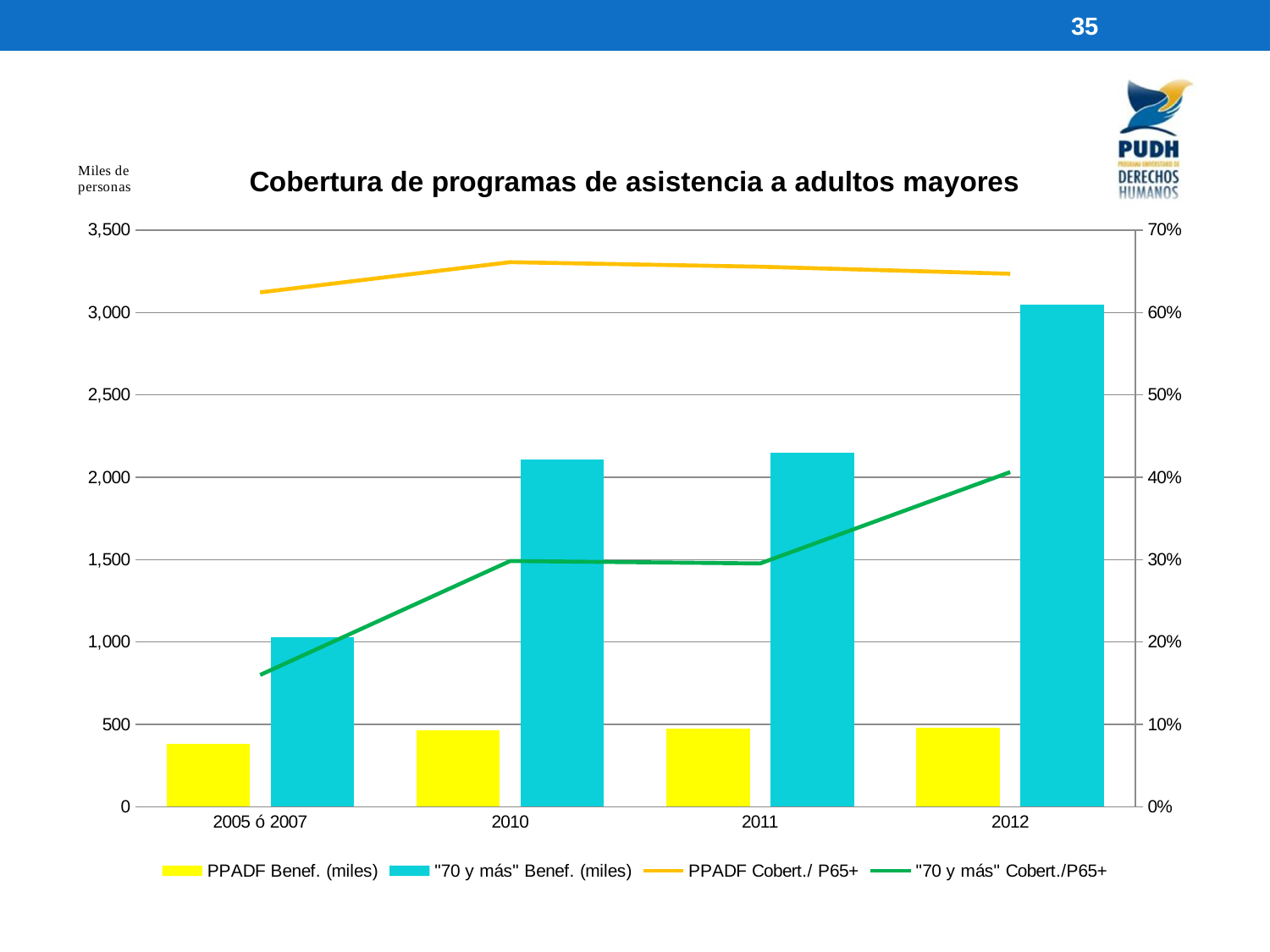
How many series does the legend list? 4 Is the value for PPADF Benef. (miles) in 2005 ó 2007 greater or less than 500? less What is the title of the chart? Cobertura de programas de asistencia a adultos mayores Which is larger in 2012: PPADF Cobert./ P65+ or "70 y más" Cobert./P65+? PPADF Cobert./ P65+ In which year is the "70 y más" Benef. (miles) bar the lowest? 2005 ó 2007 Does the "70 y más" Cobert./P65+ line generally rise or fall from 2005 ó 2007 to 2012? Rise How many categories are shown on the x axis? 4 In which year is the PPADF Benef. (miles) bar the lowest? 2005 ó 2007 Is the value for "70 y más" Cobert./P65+ in 2005 ó 2007 greater or less than 20%? less What kind of chart is shown on the slide? A combined bar and line chart Is the value for "70 y más" Benef. (miles) in 2012 greater or less than 3,000? greater In which year is the "70 y más" Benef. (miles) bar the highest? 2012